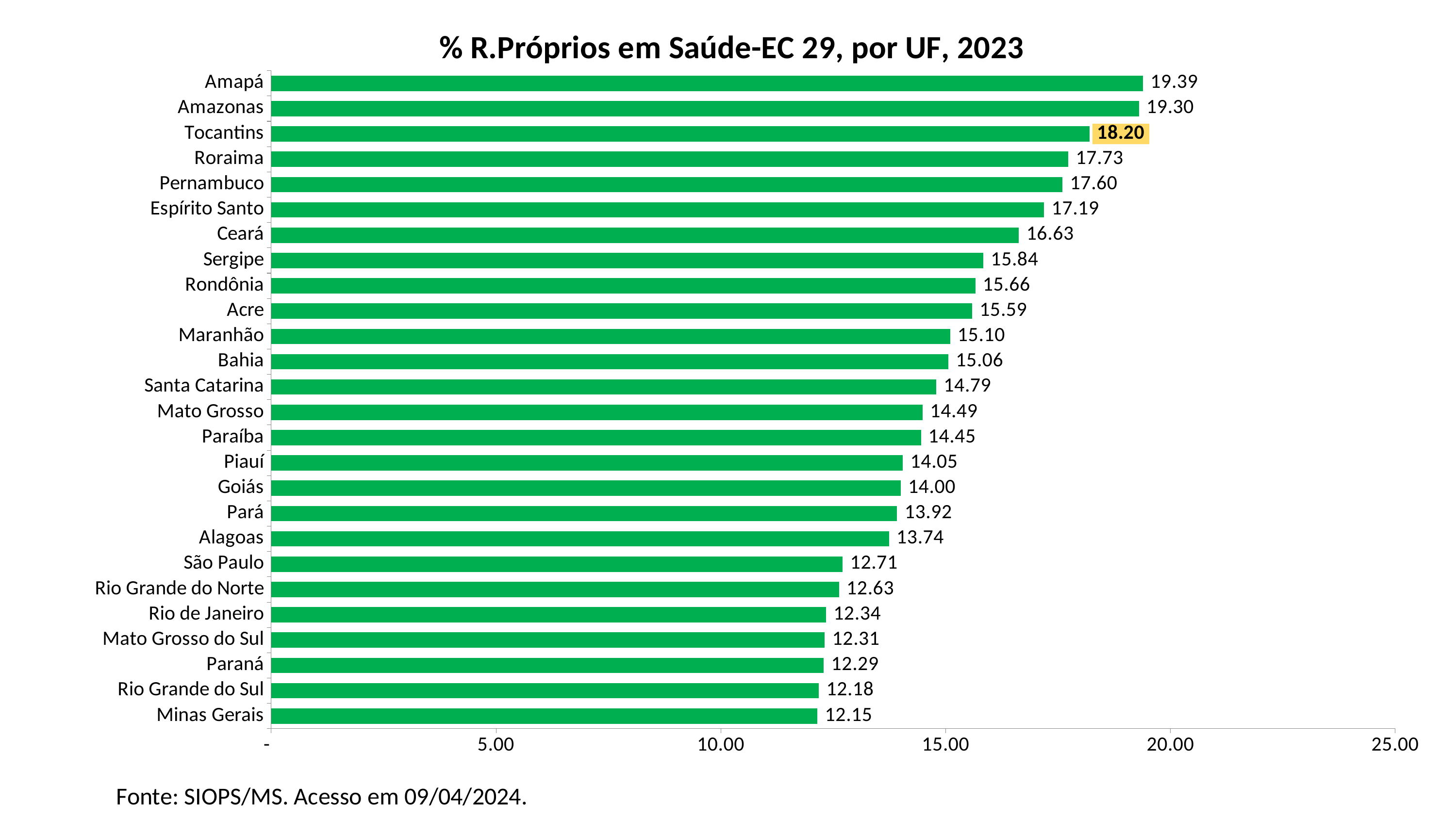
What is the difference between the values for Tocantins and Roraima? 0.47 Which UF has the lowest value? Minas Gerais What is the title of the chart? % R.Próprios em Saúde-EC 29, por UF, 2023 Is the value for Pernambuco greater or less than 15.00? greater What is the value for Minas Gerais? 12.15 What is the value for Santa Catarina? 14.79 Which UF has the highest value? Amapá How many UFs are shown in the chart? 26 What is the value for Tocantins? 18.20 What is the difference between the values for Amapá and Minas Gerais? 7.24 What kind of chart is shown on the slide? bar chart Which has a larger value, Ceará or São Paulo? Ceará